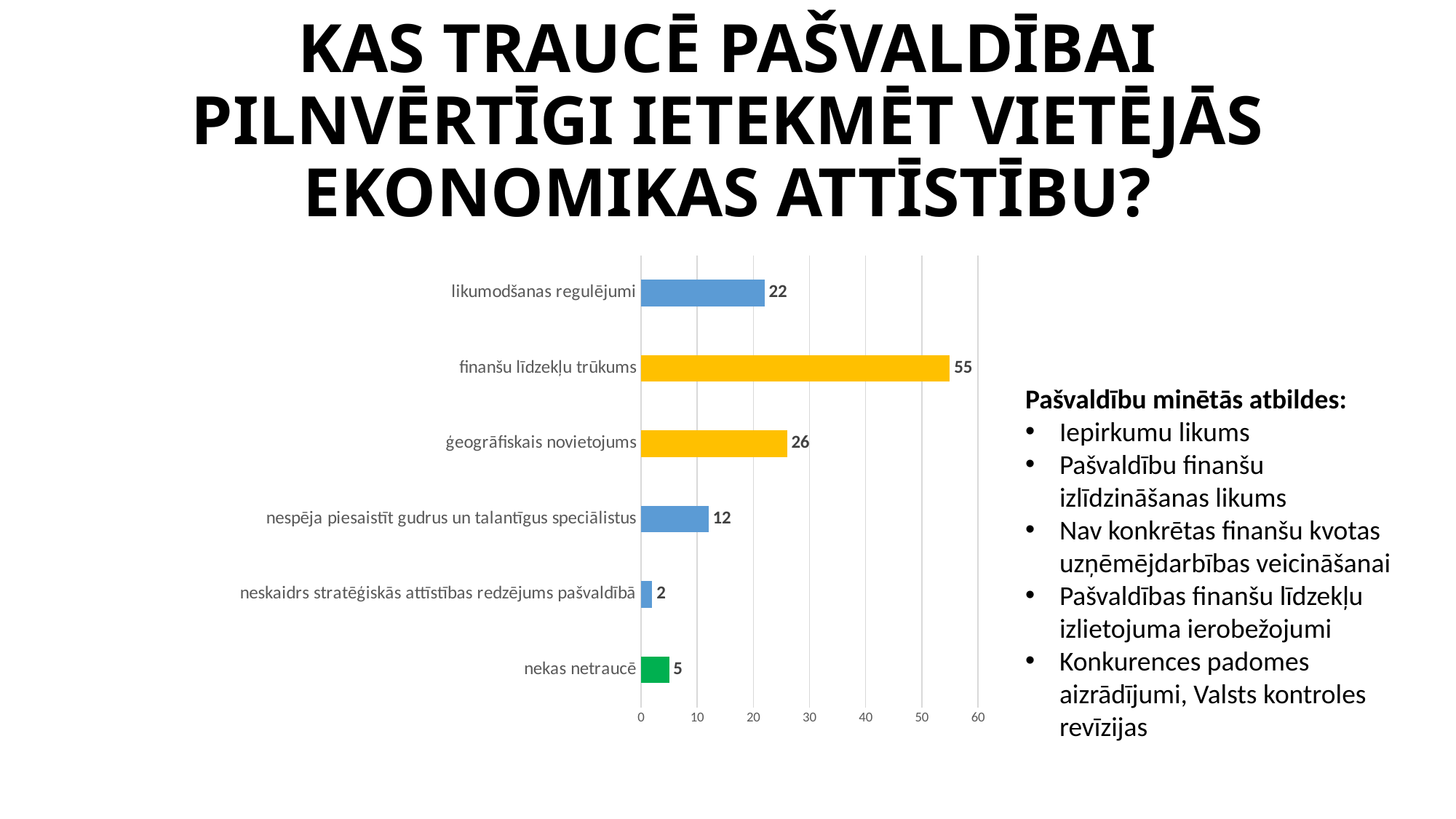
Is the value for "finanšu līdzekļu trūkums" greater or less than 50? greater Which is larger, the value for "likumodšanas regulējumi" or the value for "ģeogrāfiskais novietojums"? ģeogrāfiskais novietojums What colour is the bar for "nekas netraucē"? green What is the difference between the values for "finanšu līdzekļu trūkums" and "ģeogrāfiskais novietojums"? 29 Which category has the highest value? finanšu līdzekļu trūkums What is the value for "nekas netraucē"? 5 Which category has the lowest value? neskaidrs stratēģiskās attīstības redzējums pašvaldībā What is the value for "nespēja piesaistīt gudrus un talantīgus speciālistus"? 12 What kind of chart is shown on the slide? bar chart What is the value for "likumodšanas regulējumi"? 22 What is the value for "finanšu līdzekļu trūkums"? 55 How many categories are shown in the chart? 6